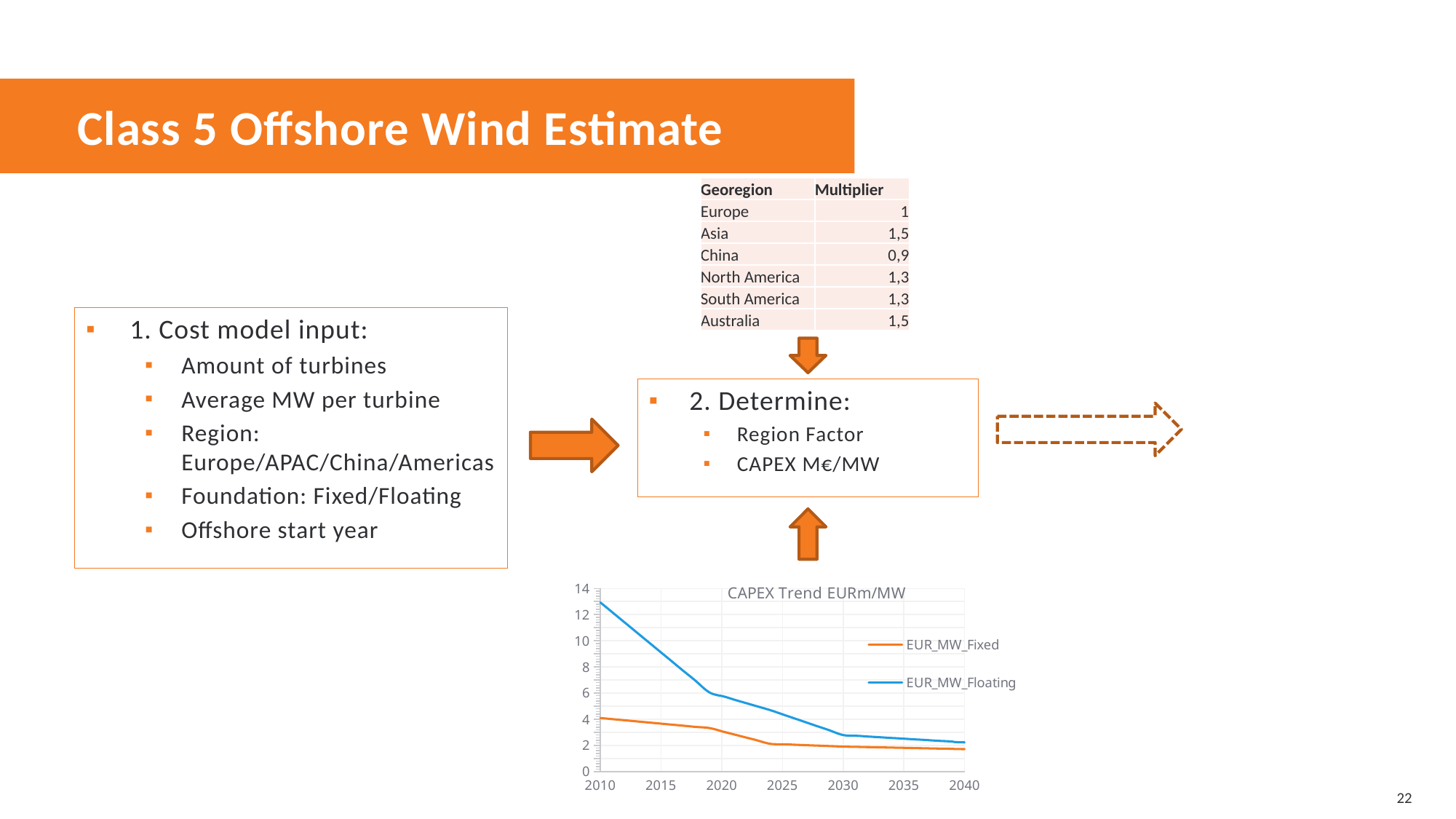
How many series does the legend of the CAPEX Trend chart list? 2 What is the title of the chart on the slide? CAPEX Trend EURm/MW Is the value for EUR_MW_Fixed in 2040 greater or less than 2? less Is the value for EUR_MW_Fixed in 2010 greater or less than 6? less Is the value for EUR_MW_Floating in 2010 greater or less than 10? greater In 2010, which series has the higher value, EUR_MW_Fixed or EUR_MW_Floating? EUR_MW_Floating What kind of chart is shown on the slide? line chart How many year labels are shown on the x axis of the chart? 7 Do the values of EUR_MW_Floating rise or fall from 2010 to 2040? fall Which colour is the EUR_MW_Floating line in the chart? blue